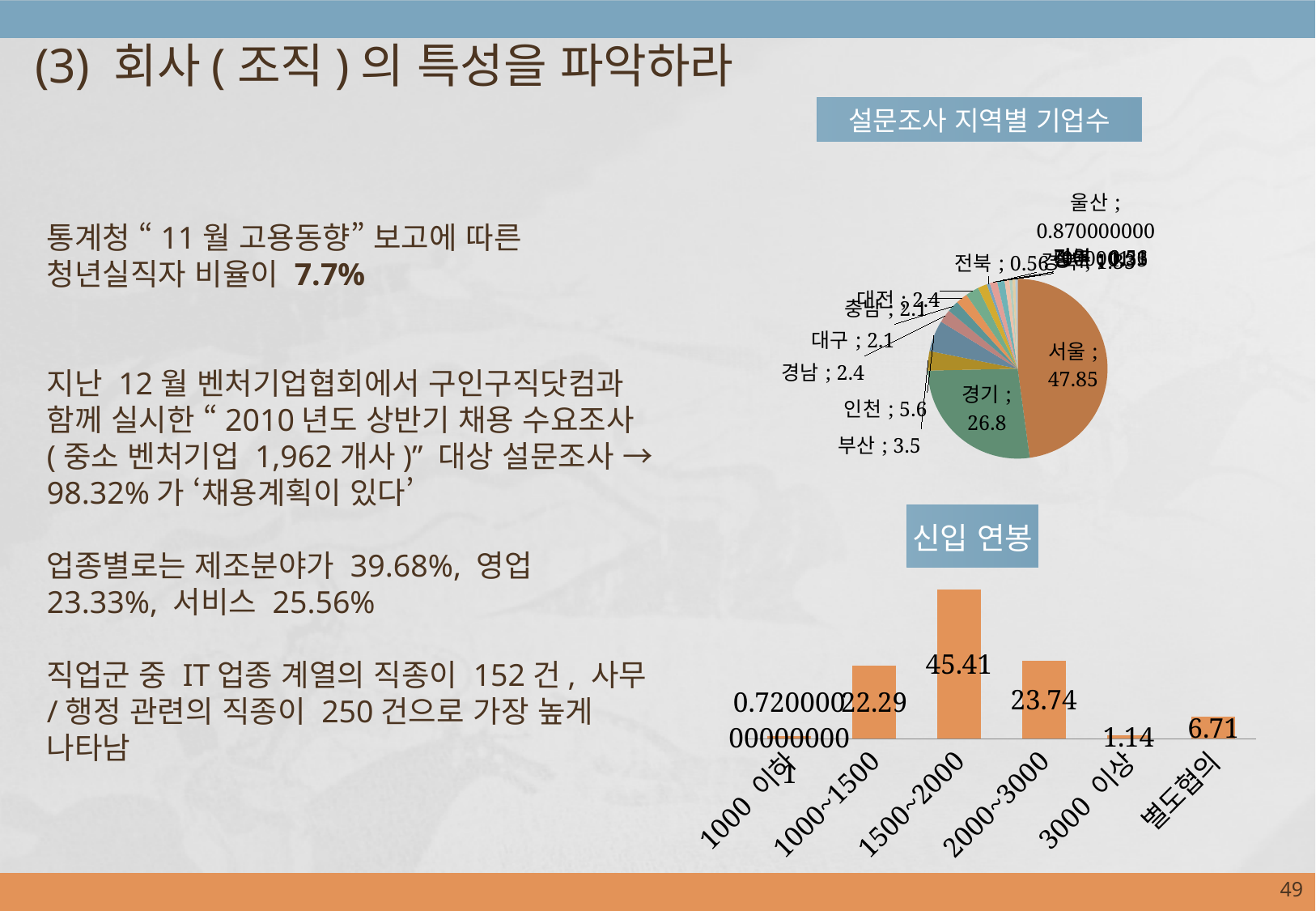
In the pie chart titled 설문조사 지역별 기업수, what is the value for 서울? 47.85 In the bar chart titled 신입 연봉, what is the value for 별도협의? 6.71 What kind of chart is the chart titled 설문조사 지역별 기업수? pie chart In the pie chart titled 설문조사 지역별 기업수, which region has the largest slice? 서울 In the pie chart titled 설문조사 지역별 기업수, what is the difference between the values for 서울 and 경기? 21.05 In the pie chart titled 설문조사 지역별 기업수, which is larger, the value for 인천 or the value for 부산? 인천 In the pie chart titled 설문조사 지역별 기업수, what is the value for 경기? 26.8 In the bar chart titled 신입 연봉, how many categories are shown on the x axis? 6 In the bar chart titled 신입 연봉, which category has the highest value? 1500~2000 What kind of chart is the chart titled 신입 연봉? bar chart In the bar chart titled 신입 연봉, what is the difference between the values for 1500~2000 and 2000~3000? 21.67 In the bar chart titled 신입 연봉, what is the value for 1500~2000? 45.41